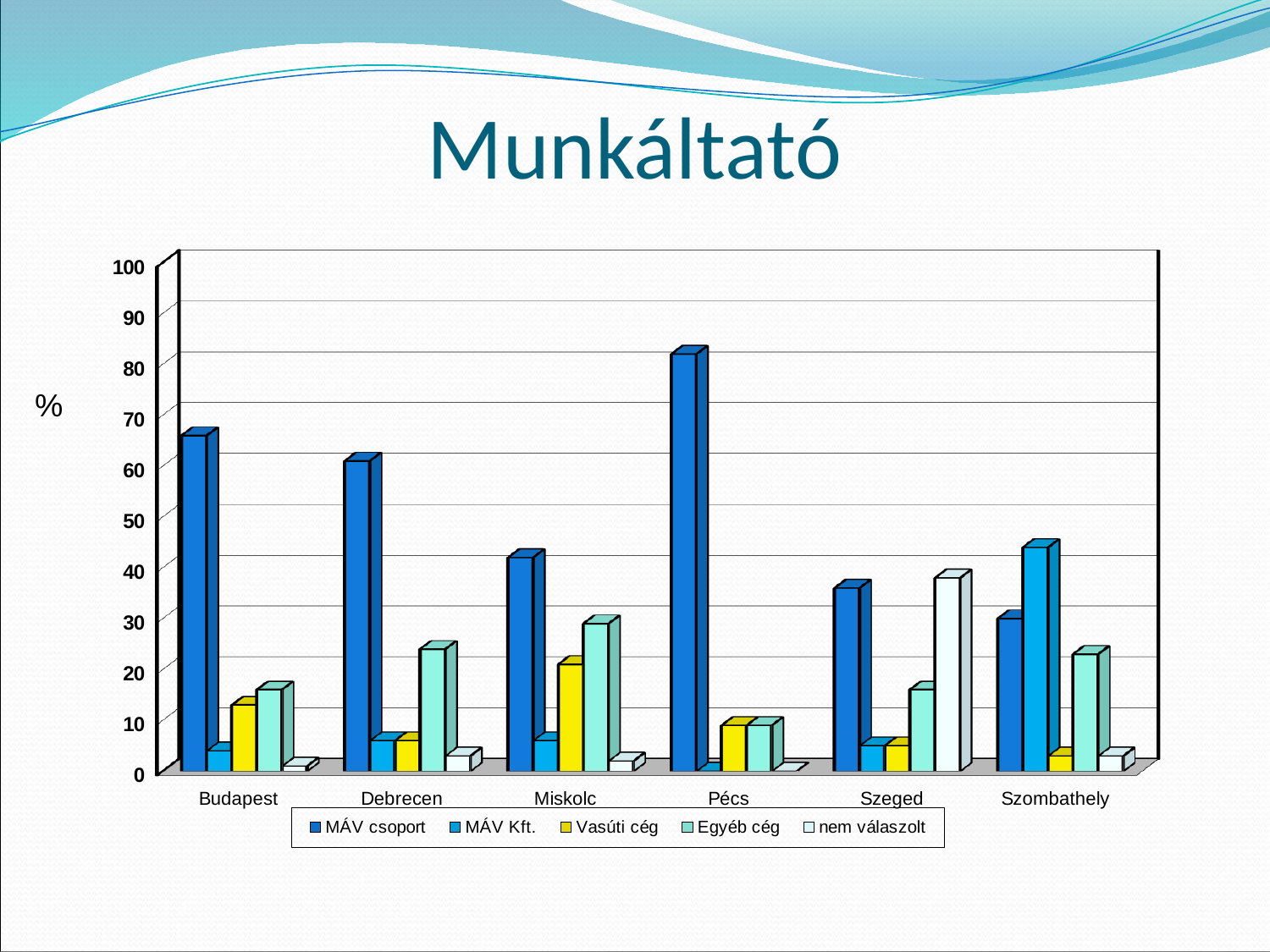
Which city has the highest value for MÁV csoport? Pécs What is the title of the slide containing the chart? Munkáltató How many cities are shown on the x axis of the chart? 6 Is the value for MÁV Kft. in Szombathely greater or less than 40? greater How many series does the legend of the chart list? 5 Which is larger in Szombathely: MÁV csoport or MÁV Kft.? MÁV Kft. Which city has the highest value for nem válaszolt? Szeged Which city has the lowest value for MÁV csoport? Szombathely Is the value for MÁV csoport in Pécs greater or less than 80? greater What kind of chart is shown on the slide? bar chart Is the value for Egyéb cég in Miskolc greater or less than 20? greater